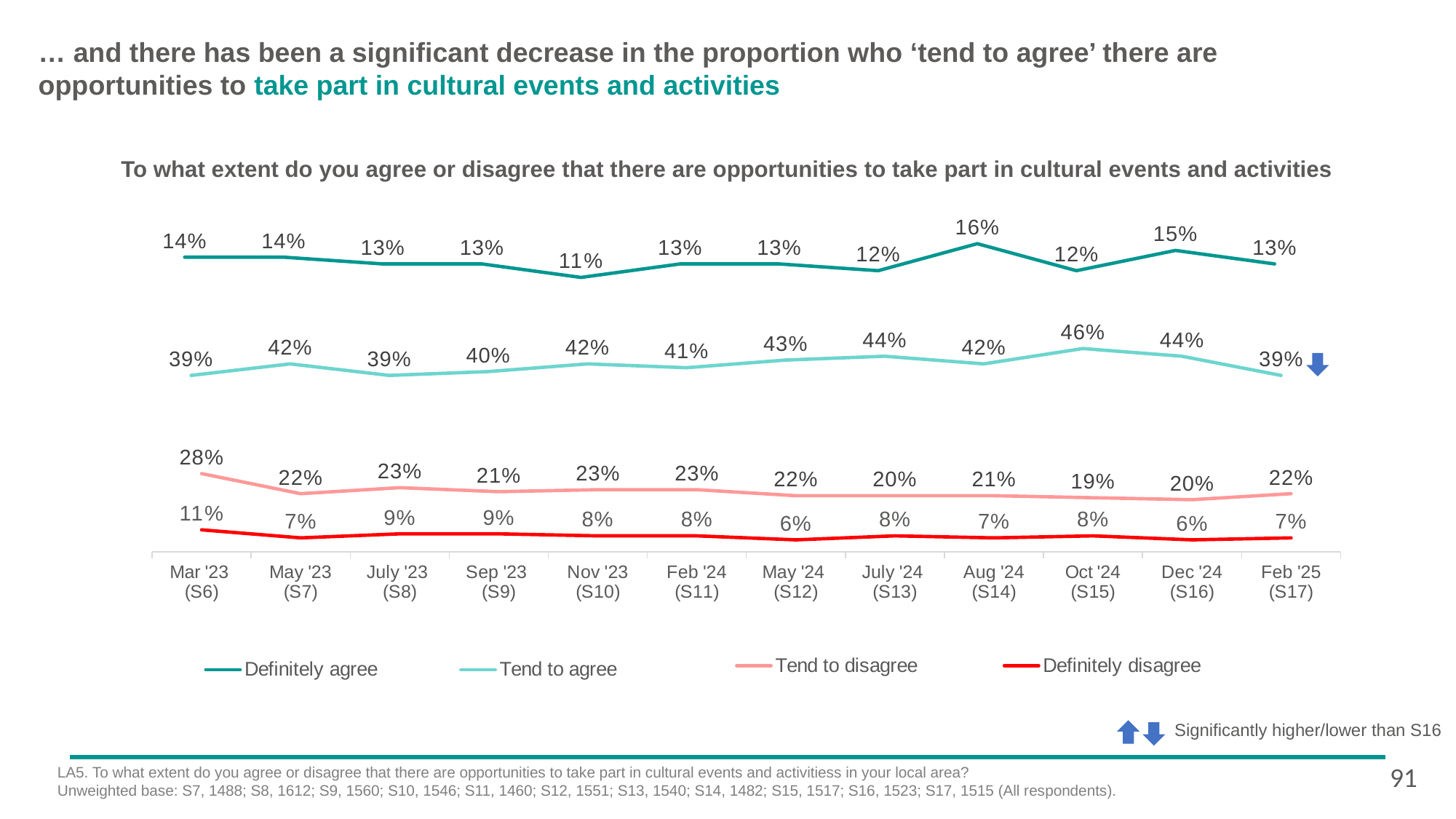
What kind of chart is shown on the slide? Line chart What is the value for 'Tend to disagree' in Mar '23 (S6)? 28% What is the value for 'Tend to agree' in Feb '25 (S17)? 39% What is the value for 'Definitely disagree' in Nov '23 (S10)? 8% Which is larger in Mar '23 (S6): 'Tend to disagree' or 'Definitely agree'? Tend to disagree What is the difference between the 'Tend to agree' values in Dec '24 (S16) and Feb '25 (S17)? 5 percentage points What is the value for 'Definitely agree' in Aug '24 (S14)? 16% Which series is shown with a red line in the legend? Definitely disagree How many series does the legend list? 4 In which wave is the 'Definitely agree' value lowest? Nov '23 (S10) How many waves (time points) are shown on the x axis? 12 In which wave is the 'Tend to agree' value highest? Oct '24 (S15)